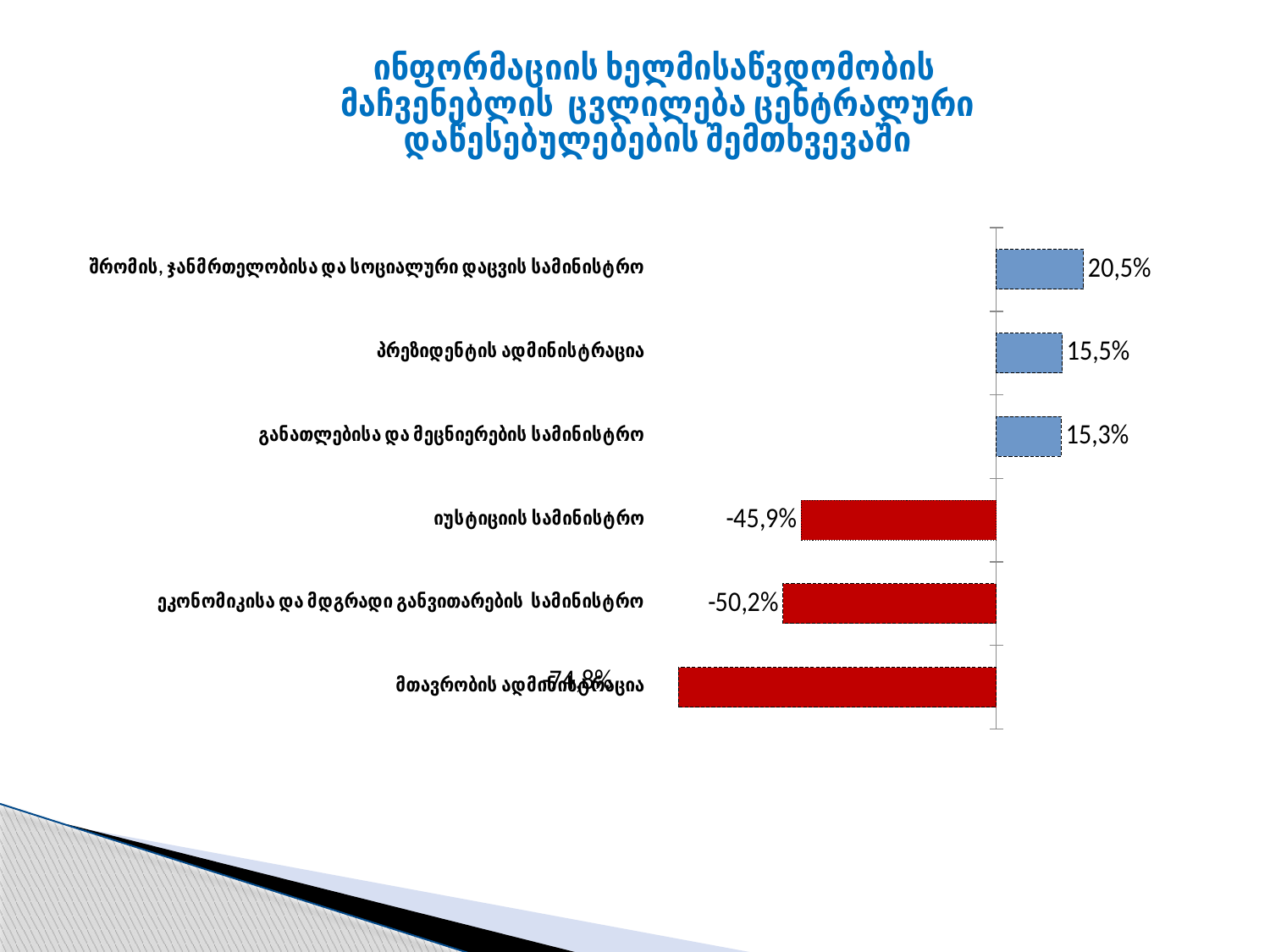
What is the value for ეკონომიკისა და მდგრადი განვითარების სამინისტრო? -50,2% What kind of chart is shown on the slide? Bar chart What is the value for პრეზიდენტის ადმინისტრაცია? 15,5% What is the value for იუსტიციის სამინისტრო? -45,9% What colour are the bars with negative values? Red How many categories are shown in the chart? 6 What is the value for განათლებისა და მეცნიერების სამინისტრო? 15,3% What is the value for შრომის, ჯანმრთელობისა და სოციალური დაცვის სამინისტრო? 20,5% What is the difference between the values for შრომის, ჯანმრთელობისა და სოციალური დაცვის სამინისტრო and პრეზიდენტის ადმინისტრაცია? 5 percentage points Which category has the lowest value? მთავრობის ადმინისტრაცია Which has the larger value, პრეზიდენტის ადმინისტრაცია or განათლებისა და მეცნიერების სამინისტრო? პრეზიდენტის ადმინისტრაცია Which category has the highest value? შრომის, ჯანმრთელობისა და სოციალური დაცვის სამინისტრო